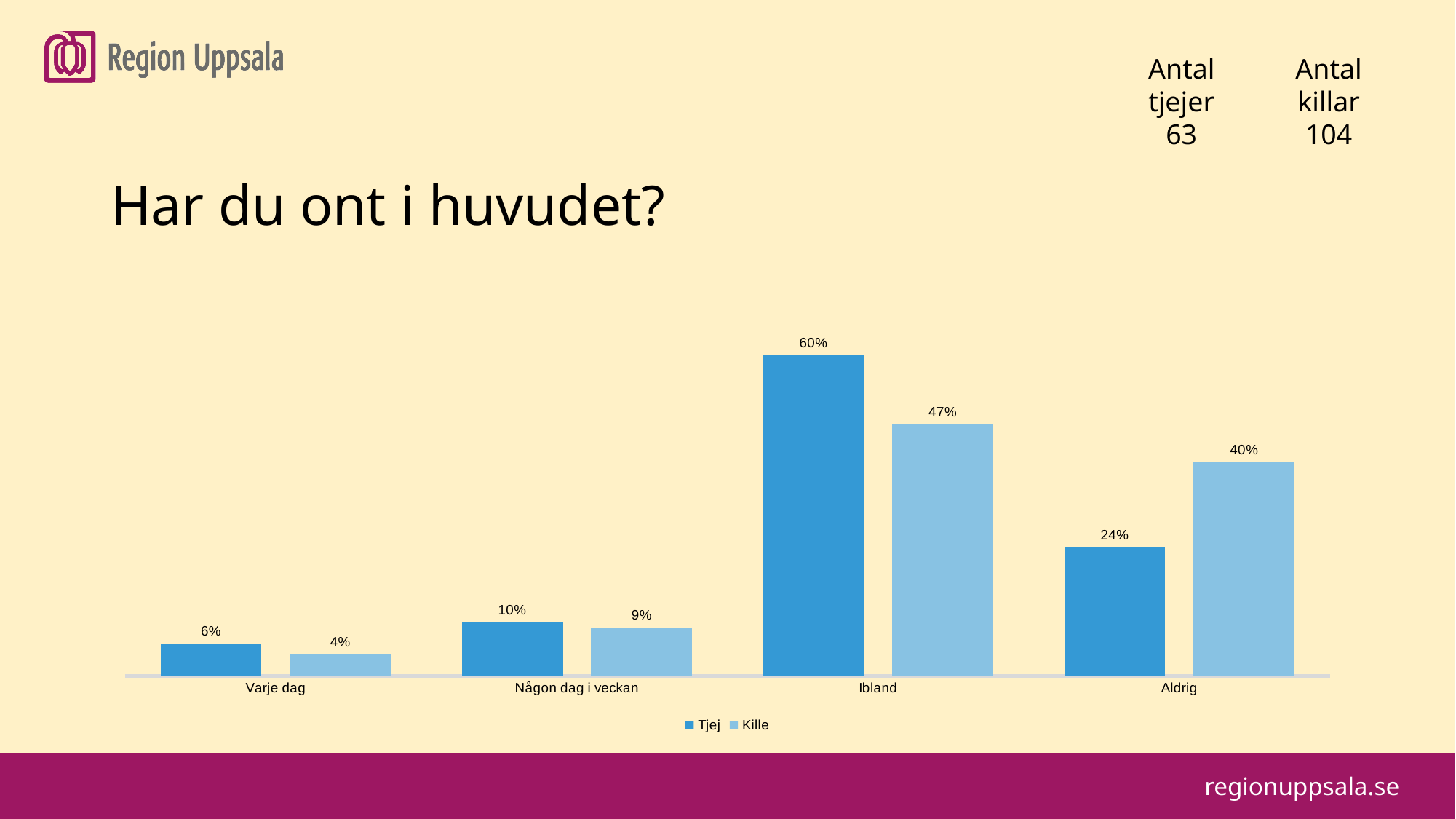
What is the difference between the Tjej and Kille values in the Ibland category? 13% What is the value for Kille in the Varje dag category? 4% In the Aldrig category, which series has the larger value, Tjej or Kille? Kille What is the value for Tjej in the Ibland category? 60% What kind of chart is shown on the slide? Bar chart What is the value for Kille in the Aldrig category? 40% Which category has the lowest value for Kille? Varje dag What is the difference between the Kille and Tjej values in the Aldrig category? 16% What is the value for Tjej in the Någon dag i veckan category? 10% Which category has the highest value for Tjej? Ibland How many series does the legend list? 2 How many categories are shown on the x axis? 4